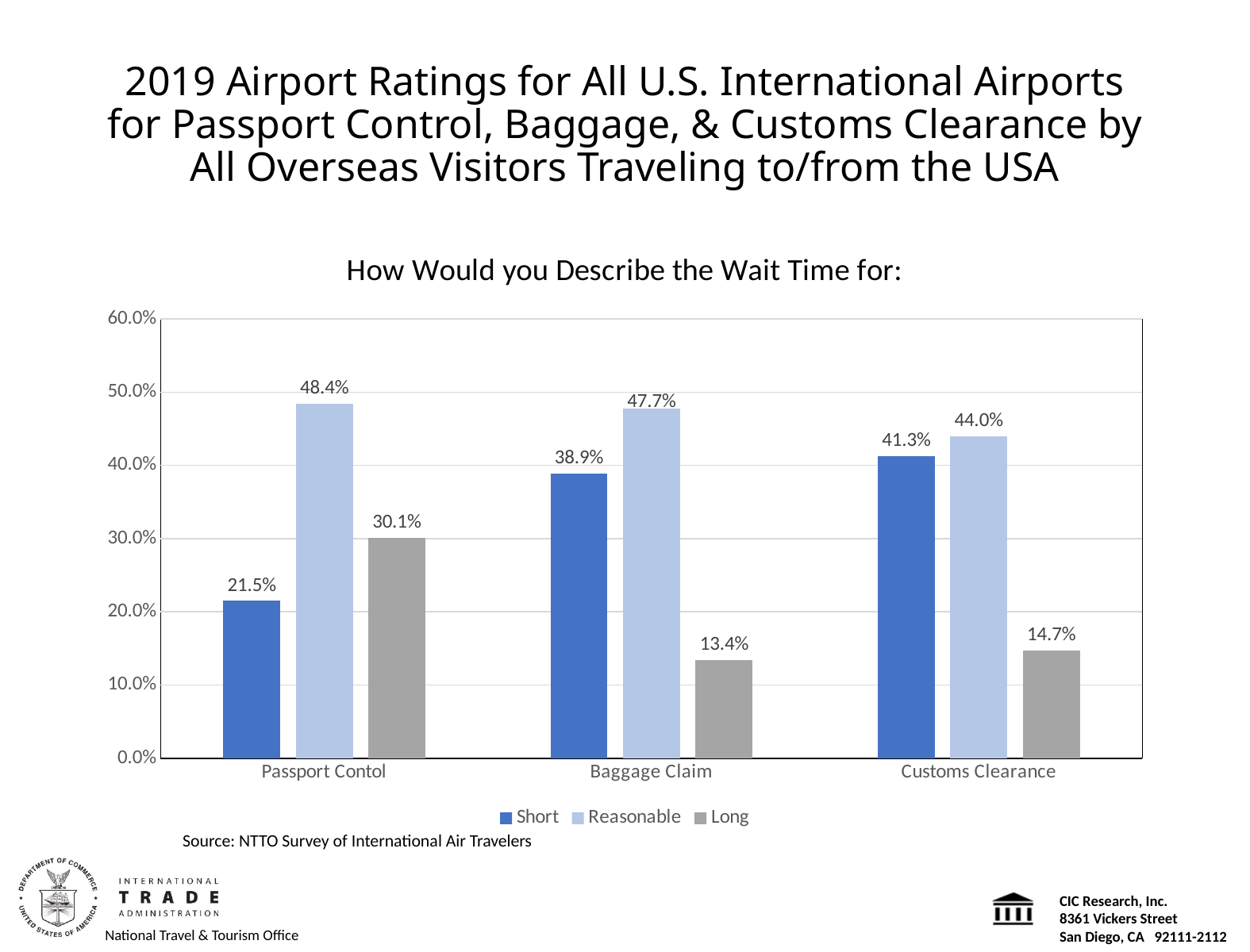
How many categories are shown on the x axis? 3 Is the Long value for Baggage Claim greater or less than 20.0%? less What kind of chart is shown on the slide? bar chart How many series does the legend list? 3 What is the difference between the Reasonable and Short values for Passport Control? 26.9% Which is larger: the Short value for Baggage Claim or the Short value for Customs Clearance? Customs Clearance What is the title of the chart? How Would you Describe the Wait Time for: What percentage described the Customs Clearance wait time as Long? 14.7% What percentage of visitors described the wait time for Passport Control as Short? 21.5% Which category has the lowest value for the Short series? Passport Contol What is the value for Reasonable wait time at Baggage Claim? 47.7% Which category has the highest value for the Long series? Passport Contol